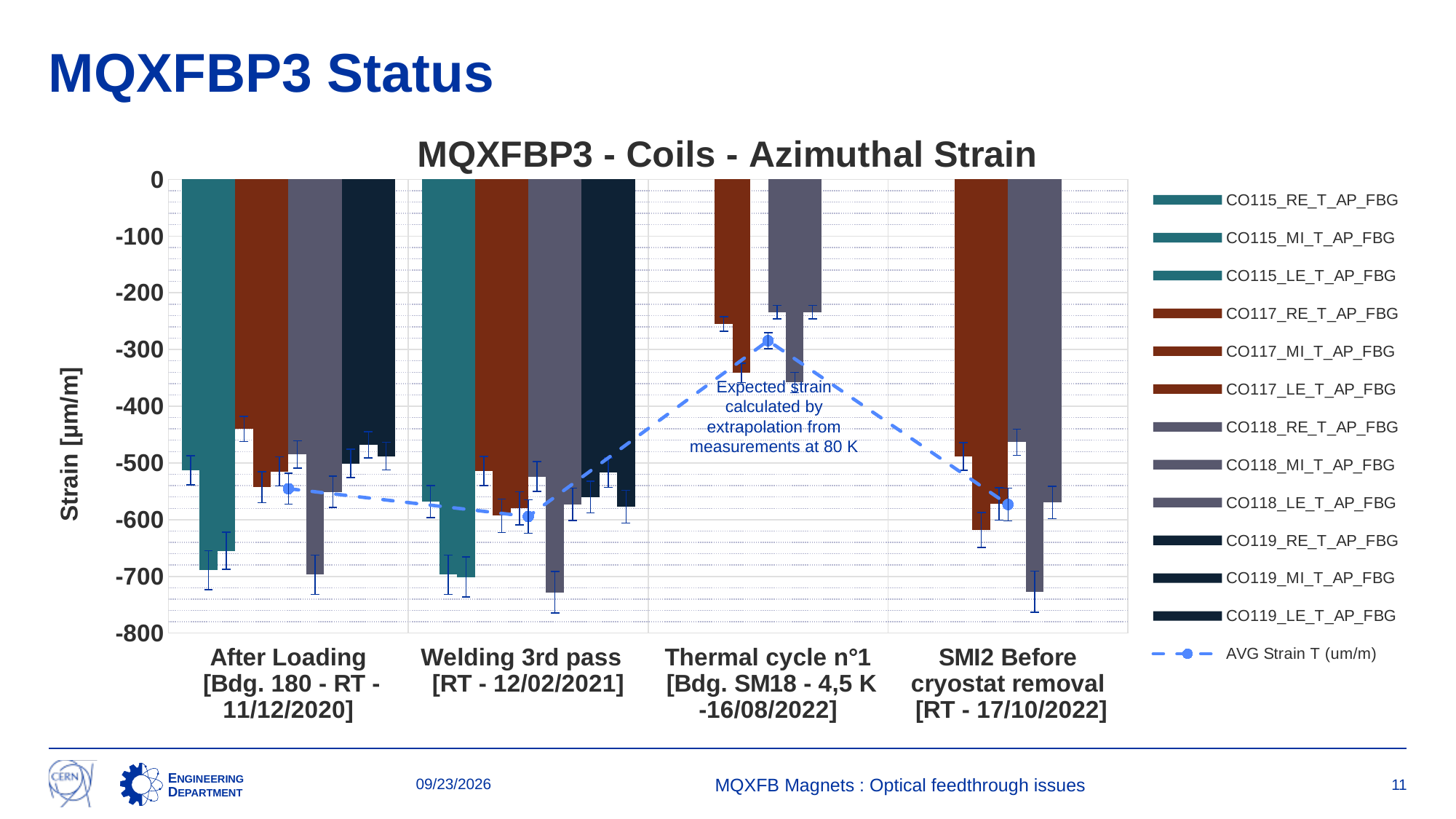
In how many of the x-axis categories are bars for the CO115 series plotted? 2 How many series does the legend list? 13 Which category has the highest (least negative) AVG Strain T value? Thermal cycle n°1 Is the AVG Strain T value for 'After Loading' greater or less than -400? less Is the AVG Strain T value for 'Thermal cycle n°1' greater or less than -400? greater What kind of chart is shown on the slide? Bar chart (with a dashed line for the average) Which is higher, the AVG Strain T value for 'Thermal cycle n°1' or for 'Welding 3rd pass'? Thermal cycle n°1 From 'After Loading' to 'Welding 3rd pass', does the AVG Strain T value rise or fall? fall What is the title of the chart? MQXFBP3 - Coils - Azimuthal Strain Is the AVG Strain T value for 'Welding 3rd pass' greater or less than -500? less How many categories are shown along the x axis? 4 What is the label of the vertical axis? Strain [µm/m]